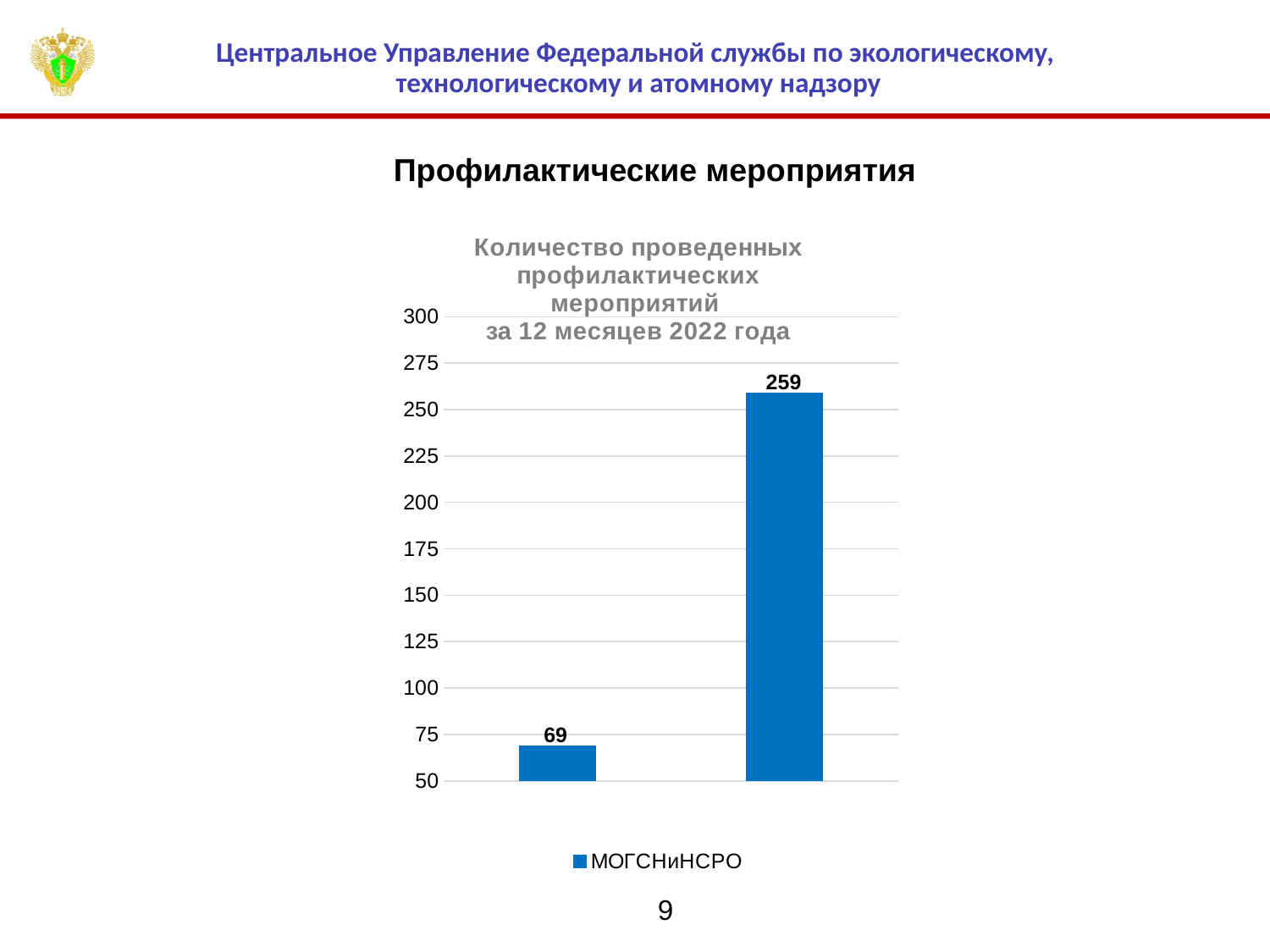
What is the value shown on the right bar of the chart? 259 What is the difference between the values of the right bar and the left bar? 190 Is the value of the left bar greater or less than 100? less Is the value of the left bar greater or less than the value of the right bar? less What is the value shown on the left bar of the chart? 69 How many bars are plotted in the chart? 2 Is the value of the right bar greater or less than 250? greater Which bar has the higher value, the left or the right one? the right bar What kind of chart is shown on the slide? bar chart Which bar has the lowest value in the chart? the left bar What series name is shown in the chart legend? МОГСНиНСРО How many series does the chart legend list? 1